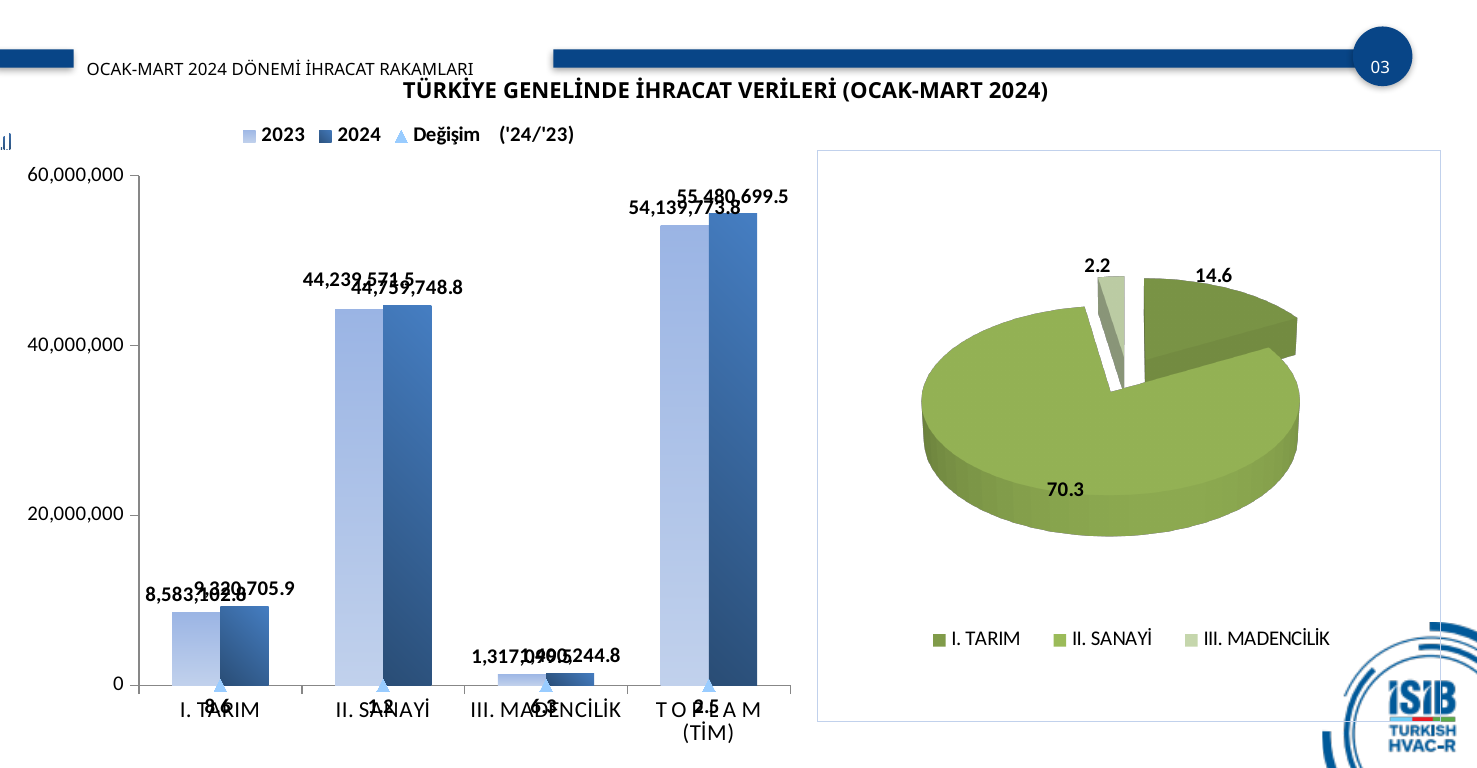
What kind of chart is the chart on the right side of the slide? pie chart In the bar chart on the left, what is the 2024 value for TOPLAM (TİM)? 55,480,699.5 In the pie chart on the right, which category has the largest share? II. SANAYİ How many slices does the pie chart on the right have? 3 In the bar chart on the left, what is the 2024 value for II. SANAYİ? 44,759,748.8 In the pie chart on the right, what value is shown for II. SANAYİ? 70.3 In the bar chart on the left, is the 2024 value for II. SANAYİ greater or less than 40,000,000? greater In the pie chart on the right, which category has the smallest share? III. MADENCİLİK What kind of chart is the chart on the left side of the slide? bar chart How many series does the legend of the bar chart on the left list? 3 In the bar chart on the left, which is larger for TOPLAM (TİM): the 2023 value or the 2024 value? 2024 In the pie chart on the right, what value is shown for I. TARIM? 14.6